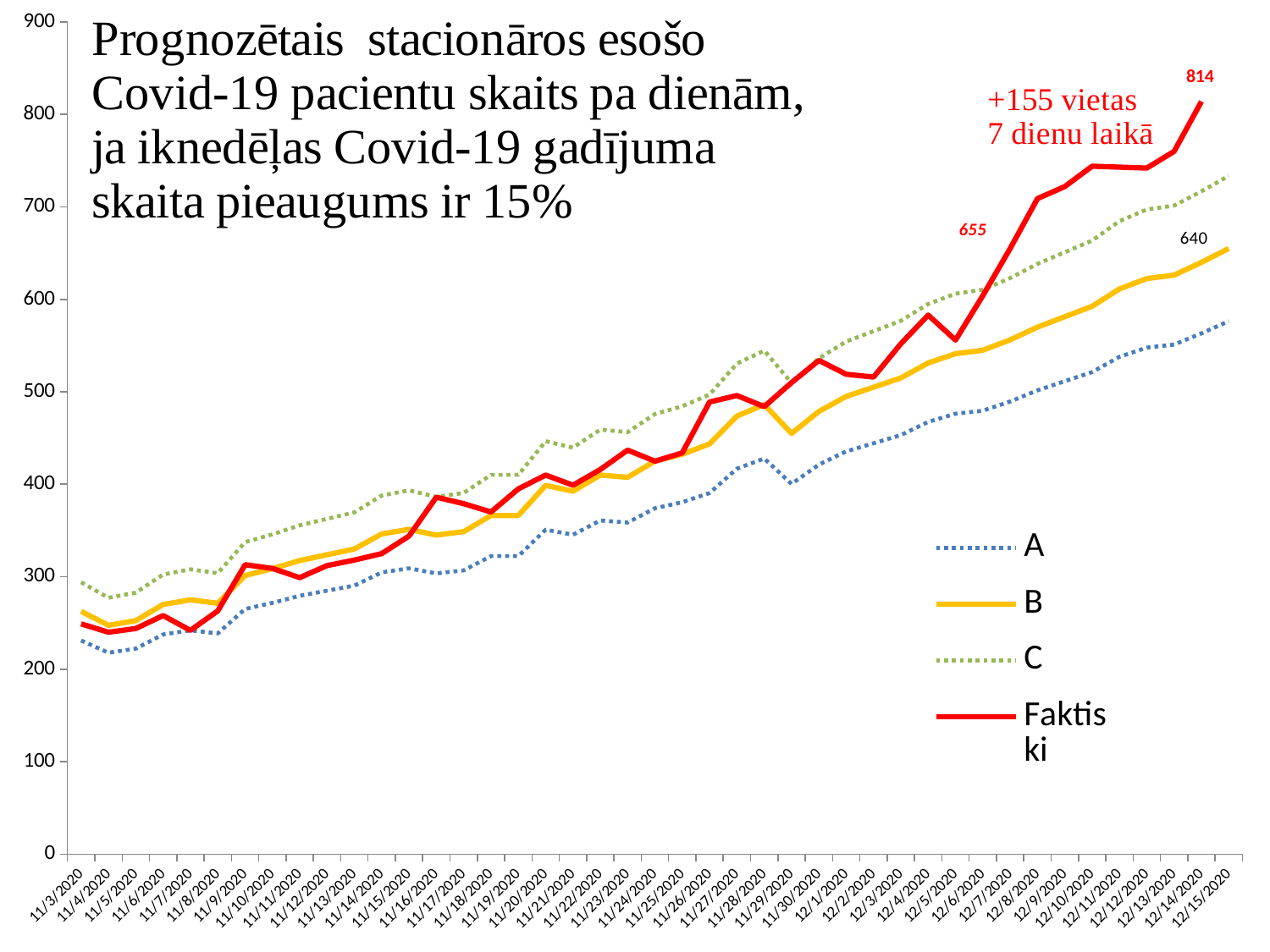
What is the difference between the Faktiski value (814) and the B value (640) on 12/14/2020? 174 How many series does the legend list? 4 What does the red annotation near the top right of the chart say? +155 vietas 7 dienu laikā What is the value of series B on 12/14/2020? 640 Do the values of series B rise or fall from 11/3/2020 to 12/15/2020? rise Is the value for series A on 12/15/2020 greater or less than 500? greater Which series has the highest value on 12/14/2020? Faktiski Which series has the lowest value on 12/15/2020? A What type of chart is shown on the slide? line chart What value is labelled on the Faktiski line on 12/7/2020? 655 What is the value of the Faktiski series on 12/14/2020? 814 On 12/15/2020, which is larger: the value for C or the value for A? C